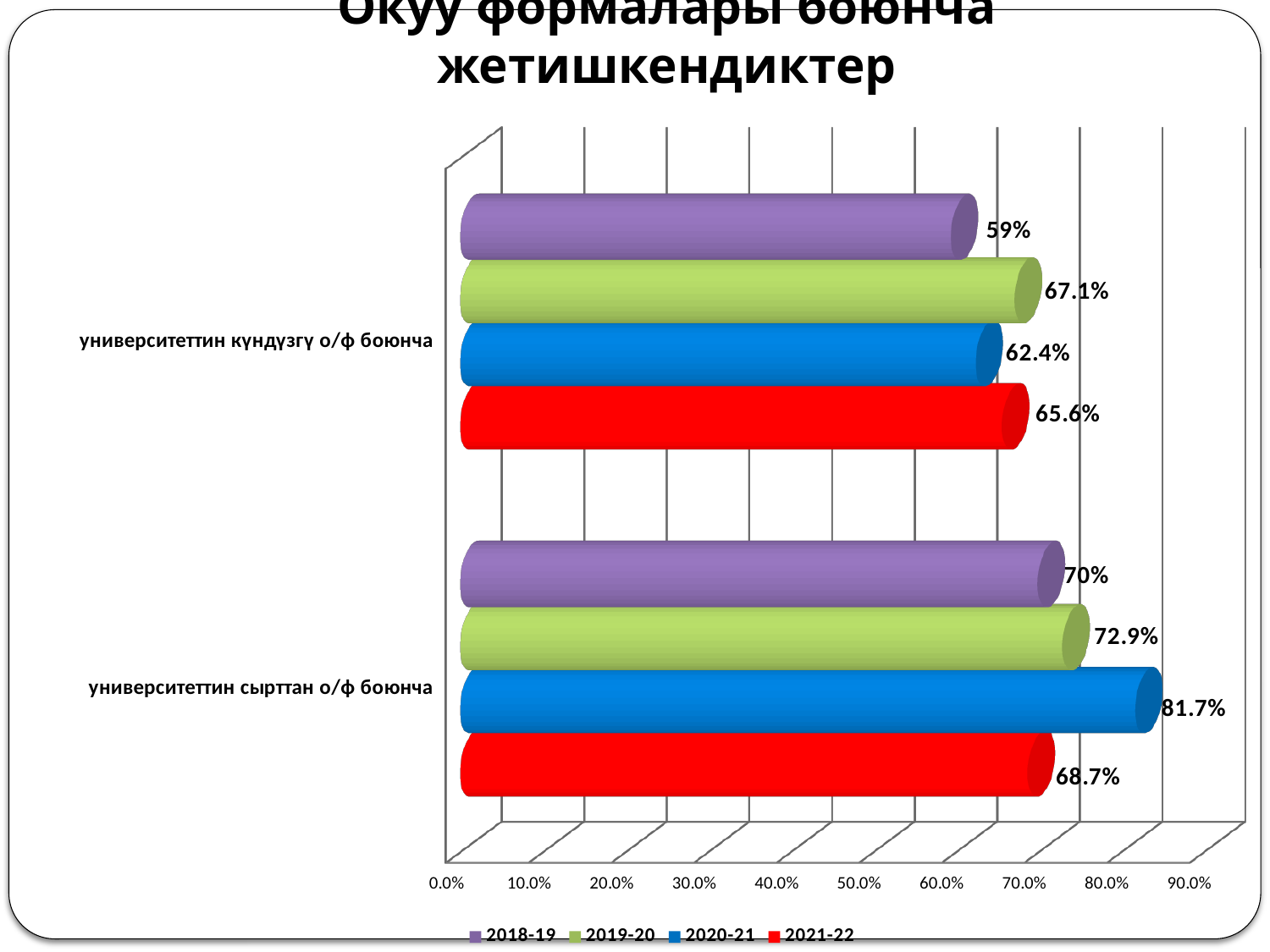
What is the value for 2018-19 for "университеттин күндүзгү о/ф боюнча"? 59% What is the difference between the 2020-21 values for "университеттин сырттан о/ф боюнча" and "университеттин күндүзгү о/ф боюнча"? 19.3% Which colour represents the 2021-22 series in the legend? red How many series does the legend list? 4 Which series has the lowest value for "университеттин күндүзгү о/ф боюнча"? 2018-19 Which series has the highest value for "университеттин сырттан о/ф боюнча"? 2020-21 Which is larger for "университеттин күндүзгү о/ф боюнча": the 2019-20 value or the 2021-22 value? 2019-20 What is the value for 2019-20 for "университеттин сырттан о/ф боюнча"? 72.9% What is the value for 2020-21 for "университеттин сырттан о/ф боюнча"? 81.7% What is the value for 2021-22 for "университеттин күндүзгү о/ф боюнча"? 65.6% How many categories are shown on the vertical axis? 2 What type of chart is shown on the slide? bar chart